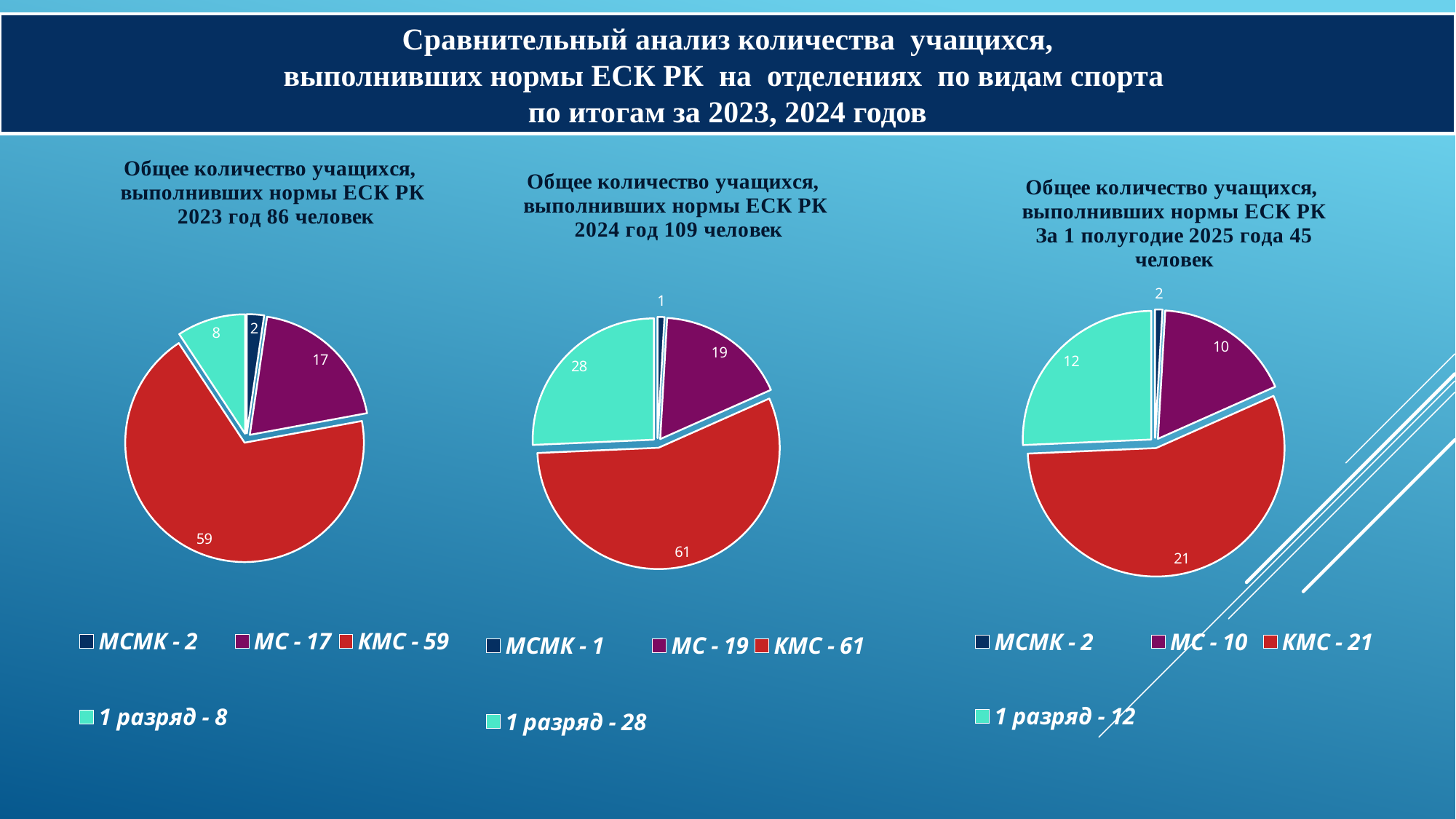
What is the total number of students shown in the 2024 chart (middle)? 109 In the 2024 chart (middle), which category has the smallest value? МСМК What colour is the КМС slice in each pie chart? Red In the 2025 first-half chart (right), which category has the largest value? КМС How many entries does the legend of the 2023 chart (left) list? 4 What type of charts are shown on the slide? Pie charts In the 2023 chart (left), how many students achieved КМС? 59 In the 2024 chart (middle), how many students achieved 1 разряд? 28 In the 2025 first-half chart (right), how many students achieved МС? 10 In the 2023 chart (left), what is the difference between КМС and МС? 42 In the 2024 chart (middle), which is larger: МС or 1 разряд? 1 разряд How many slices does the 2025 first-half chart (right) have? 4